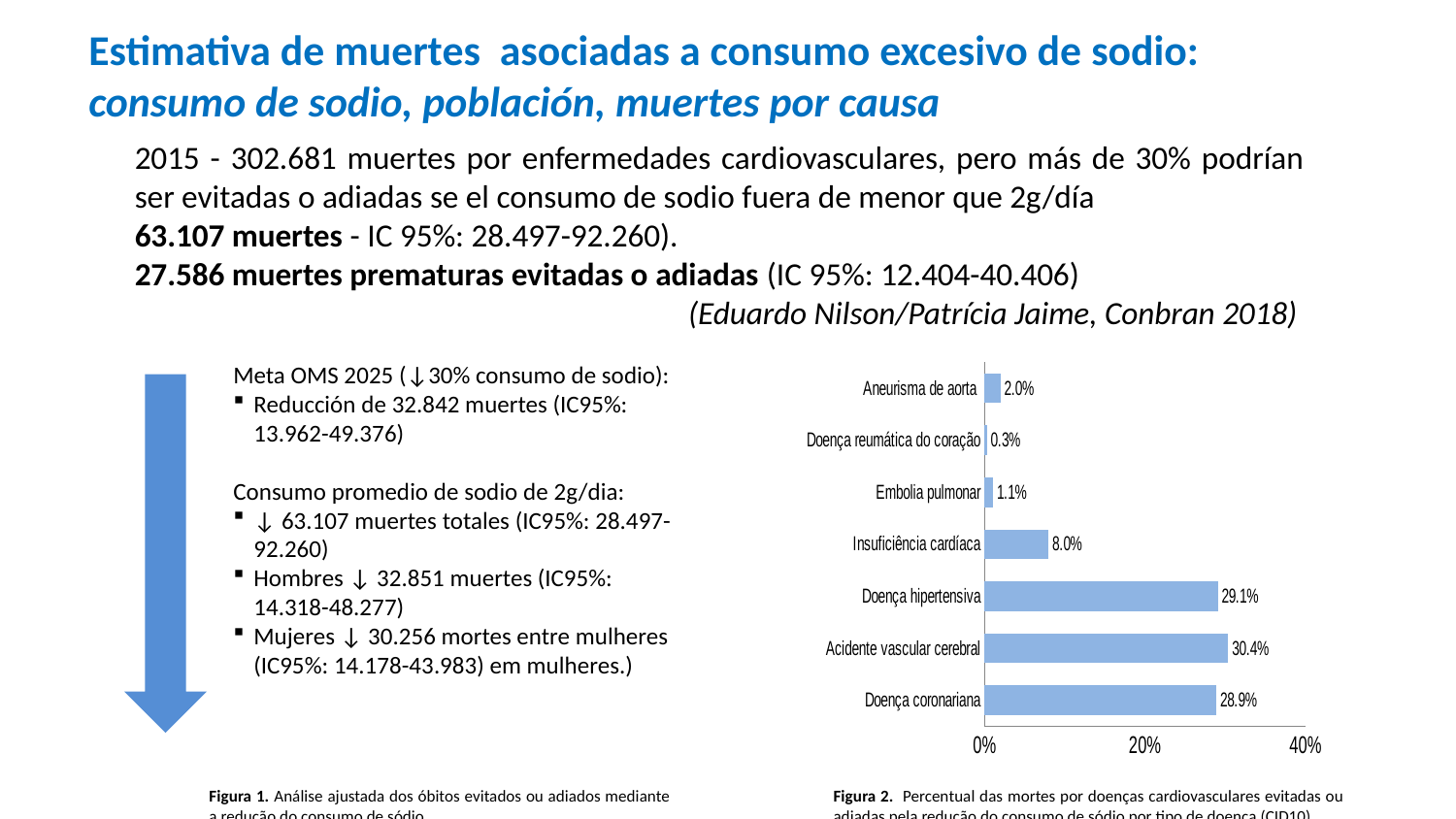
What is the value for Acidente vascular cerebral? 30.4% Which is larger, the value for Doença coronariana or the value for Embolia pulmonar? Doença coronariana Is the value for Insuficiência cardíaca greater or less than 20%? less What is the value for Insuficiência cardíaca? 8.0% How many categories (disease types) are plotted in the bar chart? 7 What is the difference between the values for Acidente vascular cerebral and Doença hipertensiva? 1.3% Which category has the highest value in the chart? Acidente vascular cerebral Which category has the lowest value in the chart? Doença reumática do coração What is the value for Doença hipertensiva? 29.1% What is the difference between the values for Insuficiência cardíaca and Aneurisma de aorta? 6.0% What kind of chart is shown on the slide? bar chart What is the value for Doença reumática do coração? 0.3%